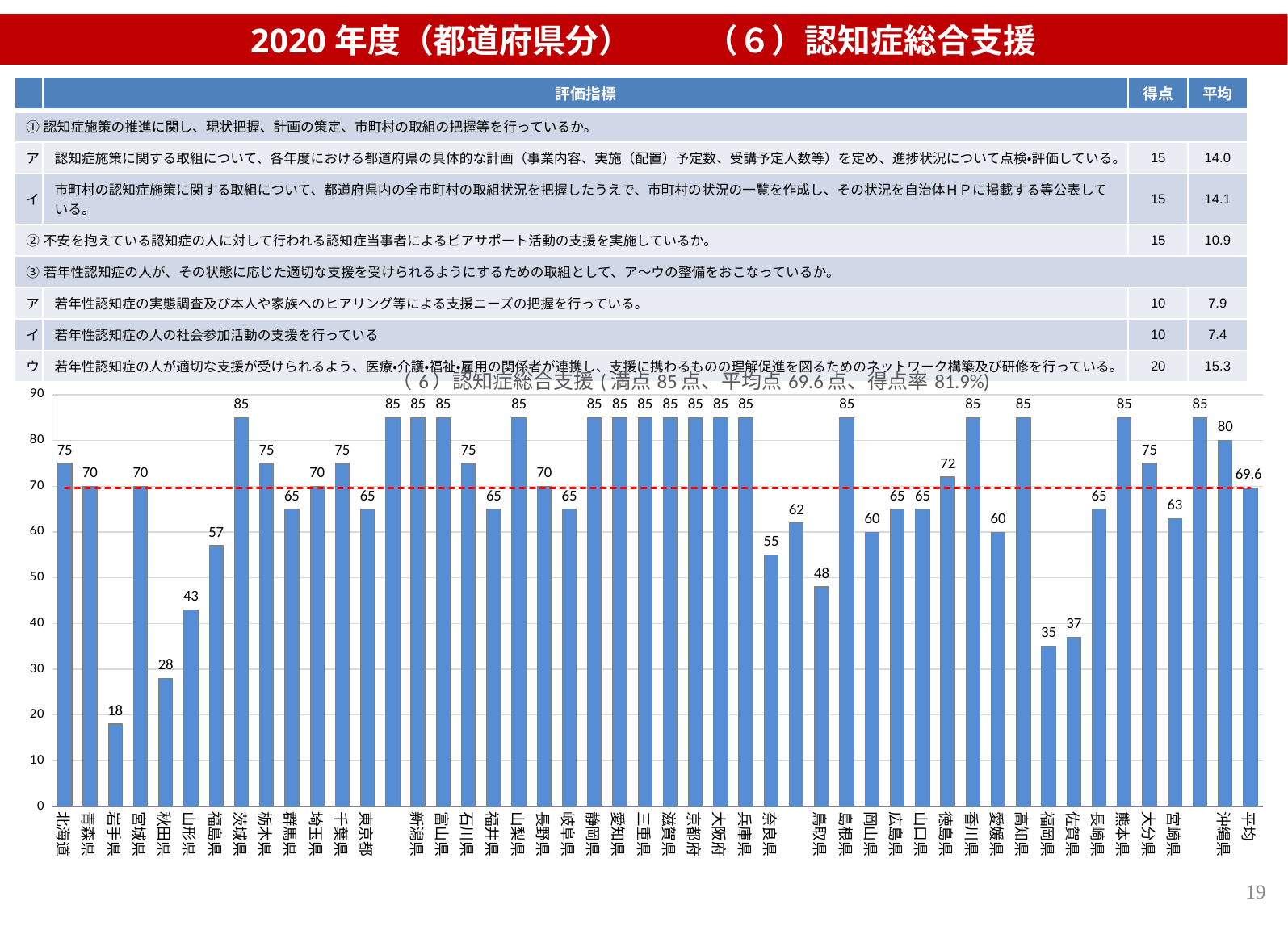
According to the chart title, what is the 満点 (maximum score) for 認知症総合支援? 85点 Which prefecture has the lowest value in the bar chart? 岩手県 Which has a larger value, 鳥取県 or 奈良県? 奈良県 What is the difference between the values for 佐賀県 and 福岡県? 2 What is the value for 徳島県 in the bar chart? 72 What kind of chart is shown on the slide? bar chart What is the value shown for 平均 (the last bar) in the chart? 69.6 Is the value for 秋田県 greater or less than 30? less What is the value for 岩手県 in the bar chart? 18 What is the value for 福岡県 in the bar chart? 35 What is the difference between the values for 北海道 and 青森県? 5 What is the value for 沖縄県 in the bar chart? 80